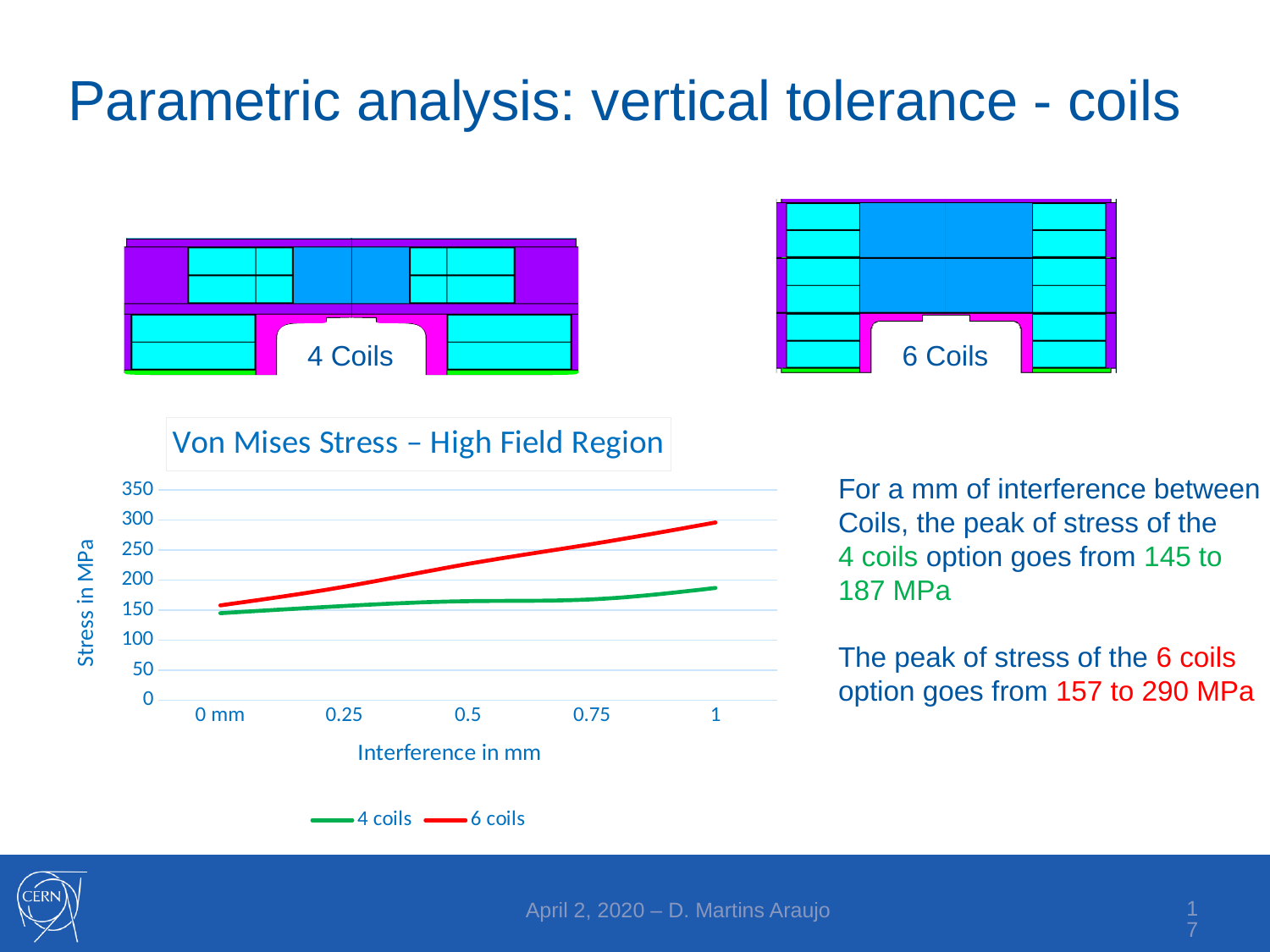
How many interference values are marked along the x axis of the chart? 5 What kind of chart is shown on the slide? line chart Which series reaches the higher stress at 1 mm interference, 4 coils or 6 coils? 6 coils Is the stress for the 6 coils series at 1 mm interference greater or less than 250? greater Is the stress for the 4 coils series at 1 mm interference greater or less than 200? less According to the slide text, what is the peak stress of the 4 coils option at 1 mm of interference? 187 MPa How many series does the legend of the chart list? 2 According to the slide text, what is the peak stress of the 6 coils option at 1 mm of interference? 290 MPa Does the stress for the 6 coils series rise or fall as interference increases from 0 mm to 1 mm? rise What is the title of the chart? Von Mises Stress – High Field Region What colour is the line for the 6 coils series? red Is the stress for the 6 coils series at 0.5 mm interference greater or less than 200? greater